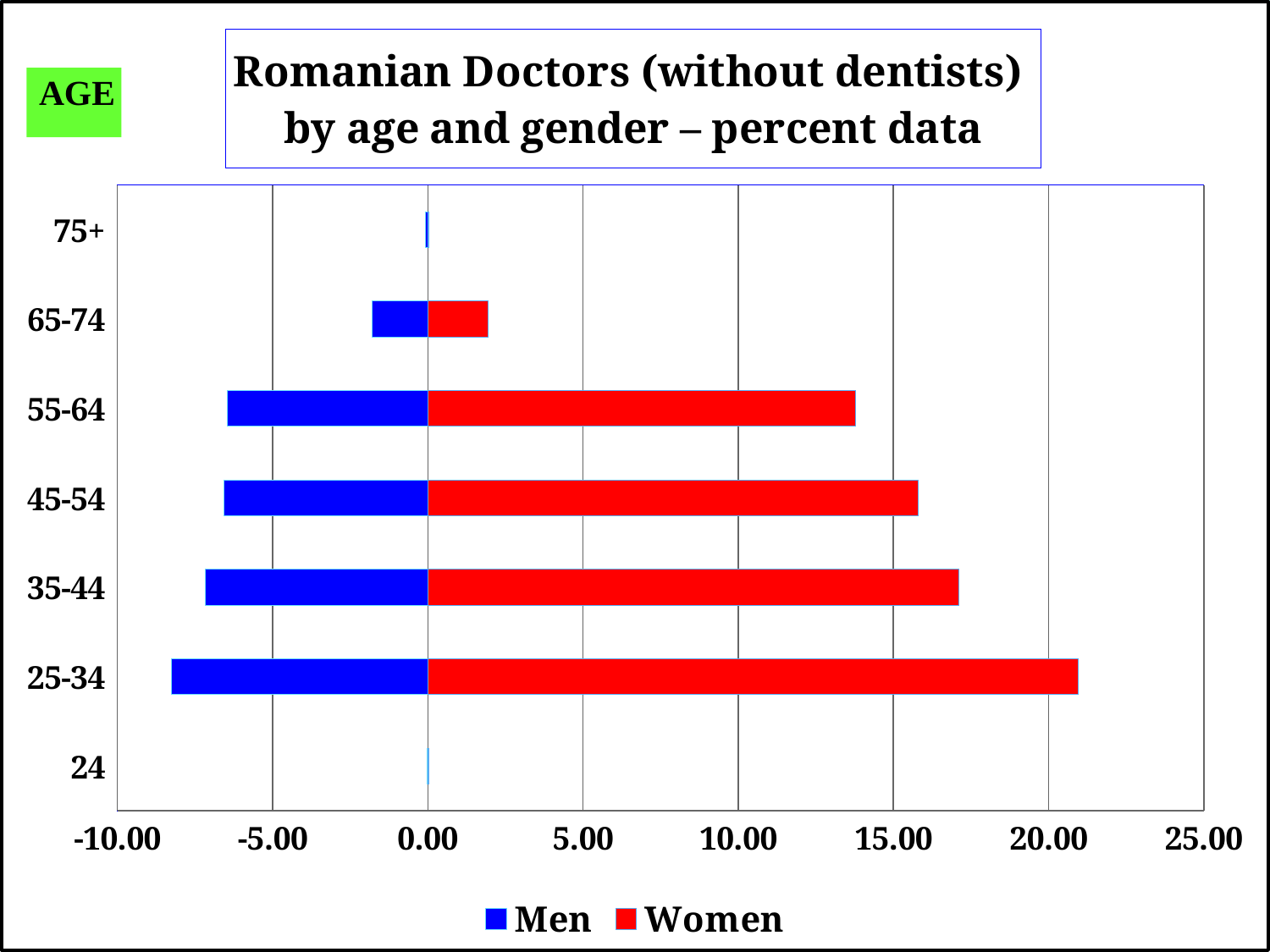
How many age categories are shown on the vertical axis? 7 Is the Women value for the 35-44 age group greater or less than 15.00? greater Moving from the 25-34 age group up to the 65-74 age group, do the Women values rise or fall? fall Which is larger for Women: the 35-44 age group or the 45-54 age group? 35-44 Is the Women value for the 25-34 age group greater or less than 20.00? greater What type of chart is shown on the slide? bar chart Which age group has the highest value for Women? 25-34 Is the Women value for the 65-74 age group greater or less than 5.00? less Which colour represents Women in the chart? red Which age group has the longest bar for Men? 25-34 How many series does the legend list? 2